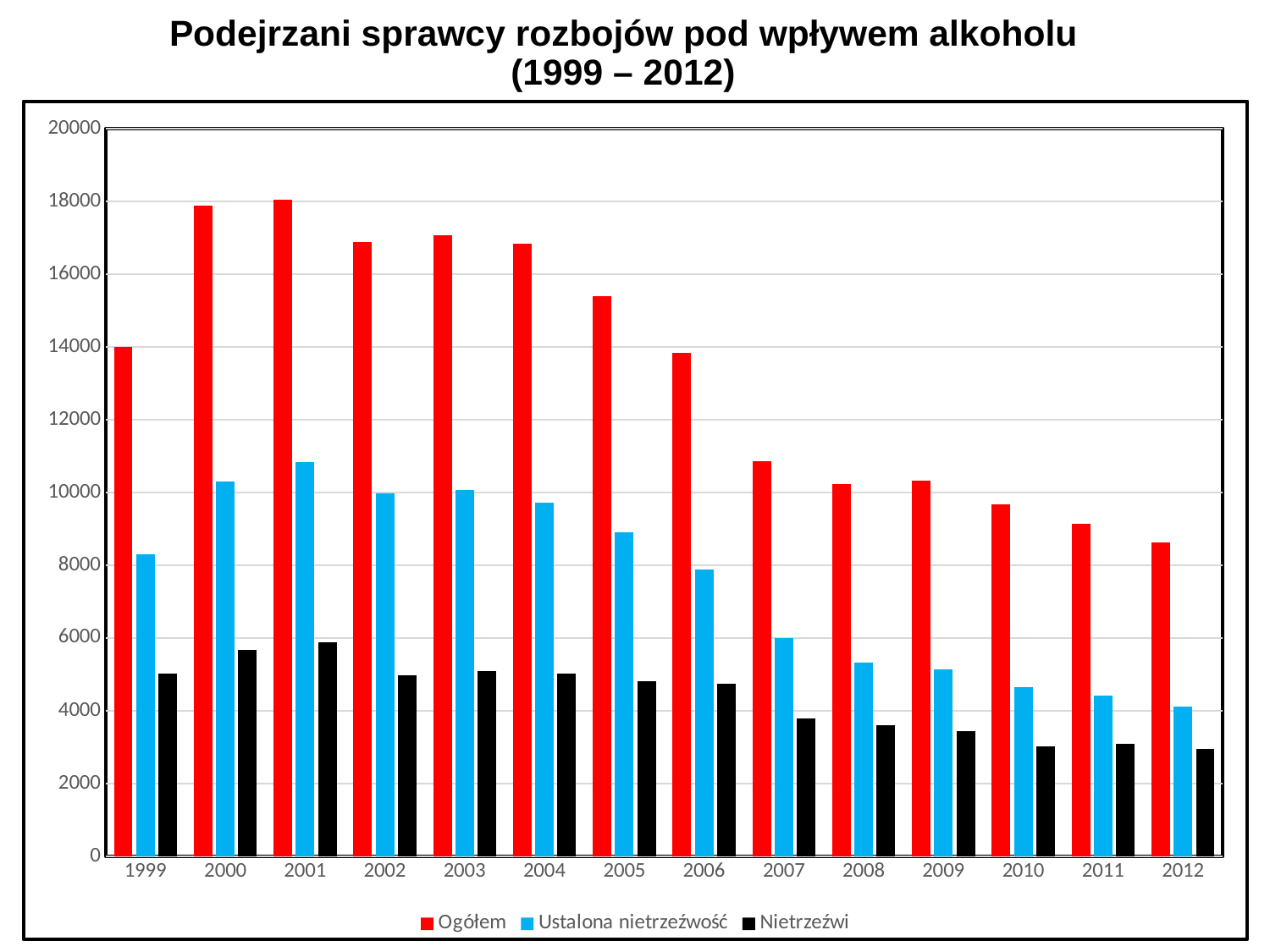
In which year is the Ustalona nietrzeźwość value highest? 2001 Is the Ogółem value for 2005 greater or less than 14000? greater Which is larger, the Ogółem value for 2000 or the Ogółem value for 2006? 2000 In which year is the Ogółem value highest? 2001 Do the Ogółem values generally rise or fall from 2001 to 2012? fall How many years are shown on the x axis? 14 Is the Ogółem value for 2007 greater or less than 10000? greater What kind of chart is shown on the slide? bar chart How many series does the legend list? 3 In which year is the Ogółem value lowest? 2012 Is the Ustalona nietrzeźwość value for 1999 greater or less than 8000? greater